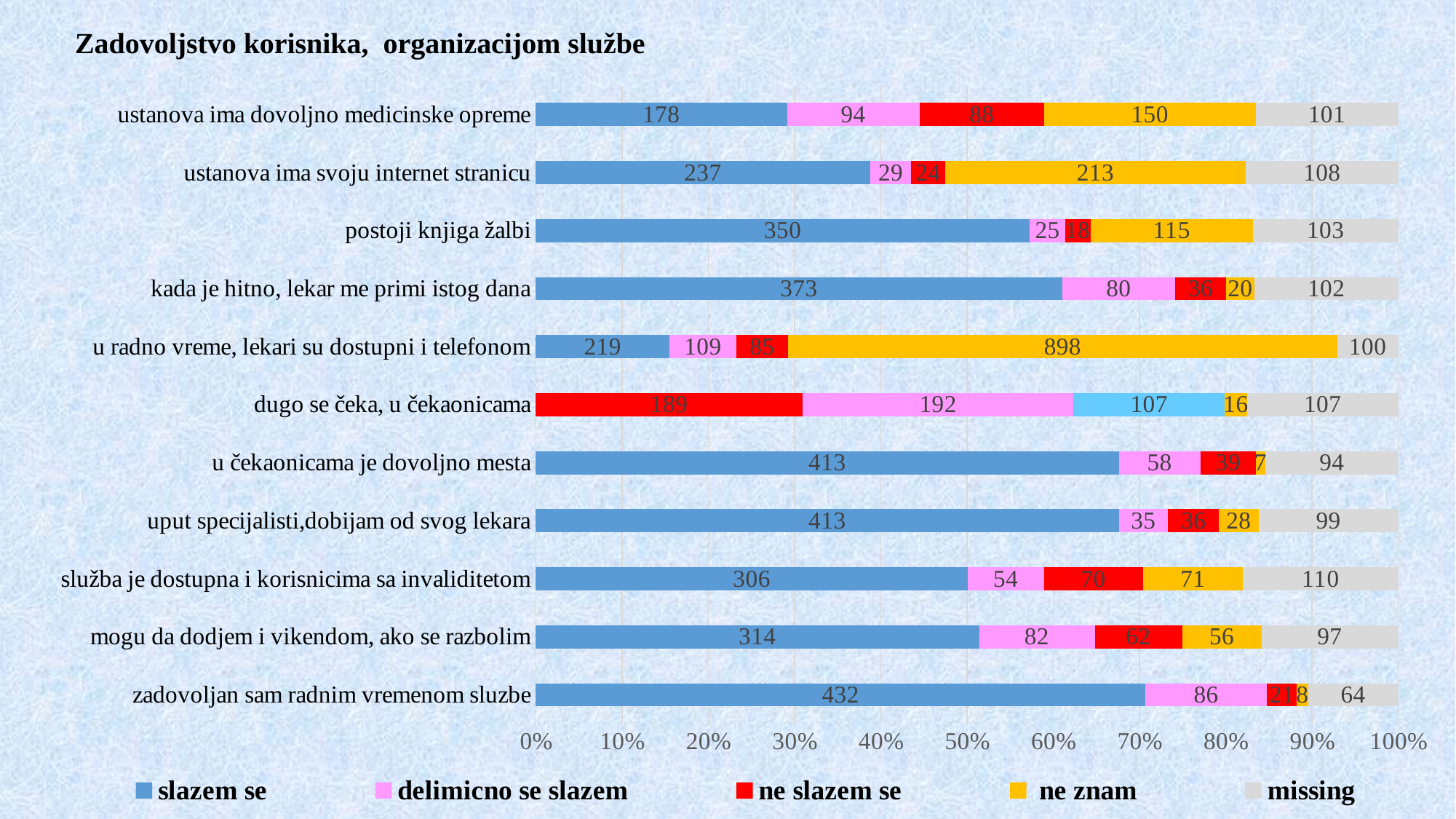
What is the 'missing' value for 'ustanova ima svoju internet stranicu'? 108 What is the total of all segments in the bar for 'ustanova ima dovoljno medicinske opreme'? 611 How many categories are shown on the chart? 11 Which has the larger 'ne slazem se' value: 'ustanova ima dovoljno medicinske opreme' or 'služba je dostupna i korisnicima sa invaliditetom'? ustanova ima dovoljno medicinske opreme Which category has the lowest 'missing' value? zadovoljan sam radnim vremenom sluzbe Which category has the highest 'slazem se' value? zadovoljan sam radnim vremenom sluzbe What is the 'slazem se' value for 'zadovoljan sam radnim vremenom sluzbe'? 432 How many series does the legend list? 5 What type of chart is shown on the slide? Stacked bar chart What is the 'ne znam' value for 'u radno vreme, lekari su dostupni i telefonom'? 898 What is the difference between the 'slazem se' values for 'postoji knjiga žalbi' and 'ustanova ima svoju internet stranicu'? 113 What is the 'delimicno se slazem' value for 'kada je hitno, lekar me primi istog dana'? 80